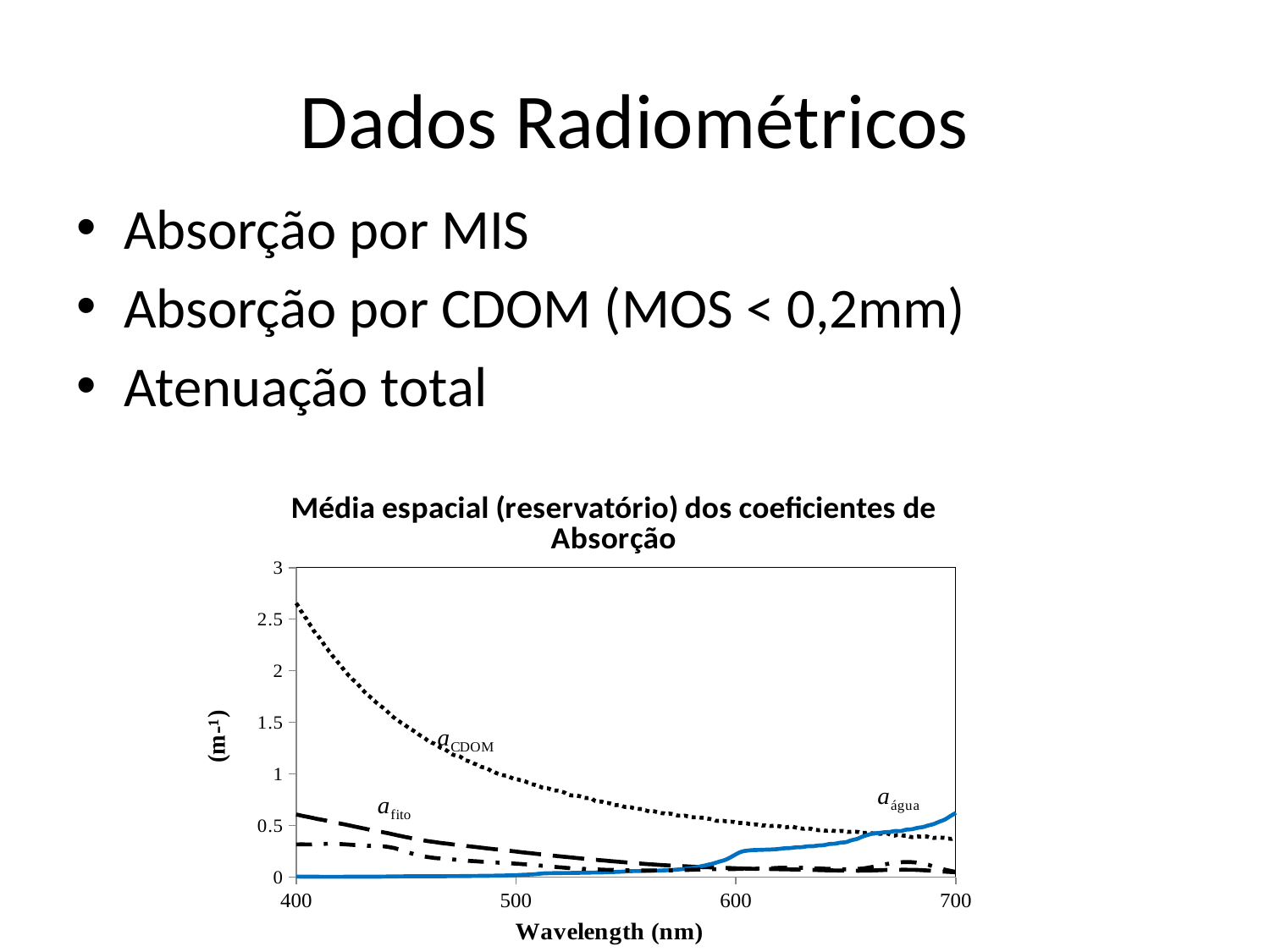
At 400 nm, which is larger: a_CDOM or a_fito? a_CDOM Which series has the lowest value at 400 nm? a_água What is the label of the x axis of the chart? Wavelength (nm) Is the value of a_fito at 400 nm greater or less than 1? less Is the value of a_CDOM at 400 nm greater or less than 2.5? greater Is the value of a_água at 700 nm greater or less than 0.5? greater What kind of chart is shown on the slide? line chart What is the title of the chart? Média espacial (reservatório) dos coeficientes de Absorção Does the a_água series rise or fall as wavelength increases from 400 to 700 nm? rise Does the a_CDOM series rise or fall as wavelength increases from 400 to 700 nm? fall Which series has the highest value at 400 nm? a_CDOM